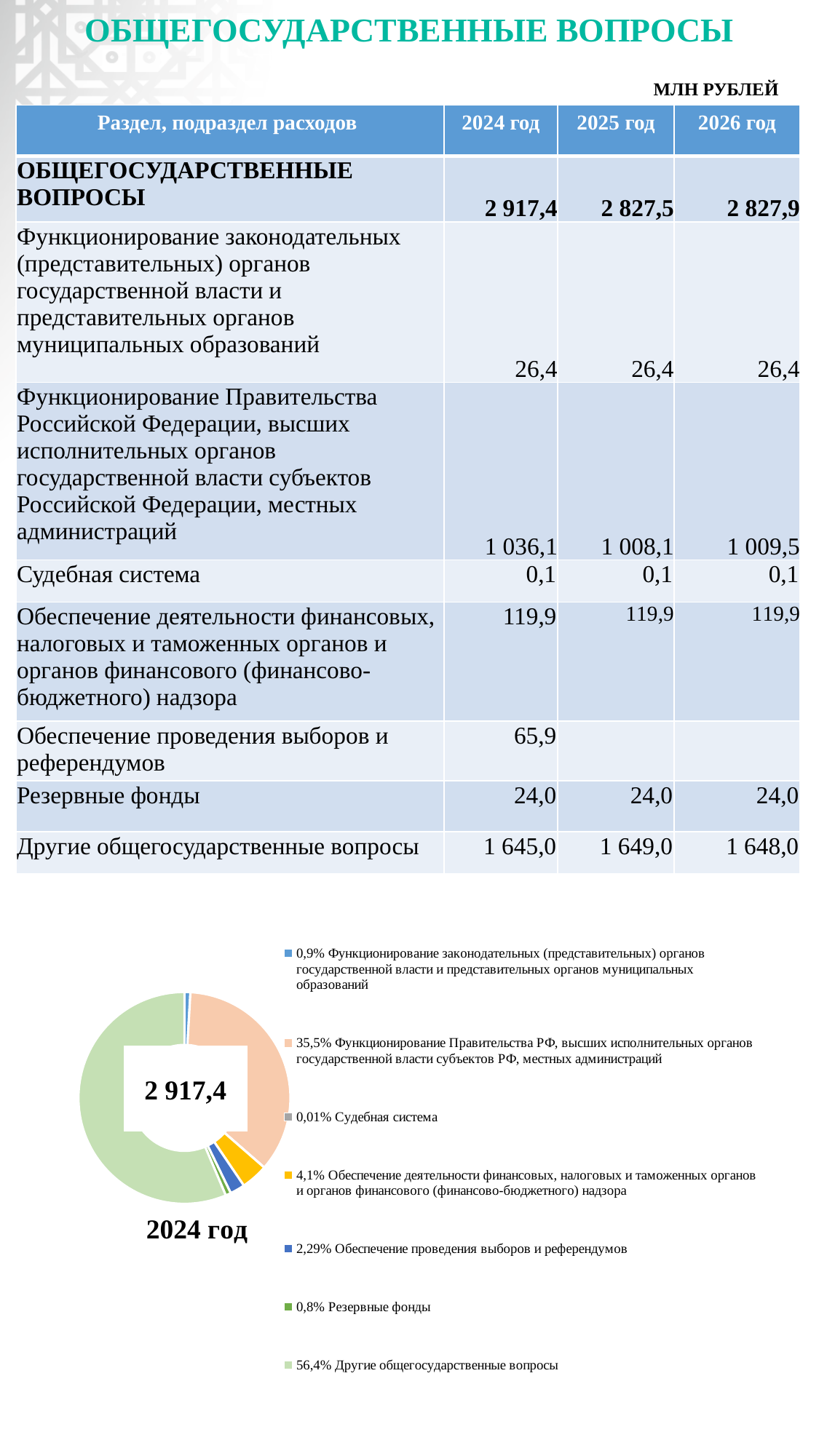
In the 2024 doughnut chart, which share is larger: "Обеспечение деятельности финансовых, налоговых и таможенных органов..." or "Обеспечение проведения выборов и референдумов"? Обеспечение деятельности финансовых, налоговых и таможенных органов и органов финансового (финансово-бюджетного) надзора What share of the 2024 doughnut chart is labelled "Судебная система"? 0,01% What share of the 2024 doughnut chart is labelled "Другие общегосударственные вопросы"? 56,4% What share of the 2024 doughnut chart is labelled "Резервные фонды"? 0,8% What total value is printed in the centre of the 2024 doughnut chart? 2 917,4 What kind of chart is shown at the bottom of the slide? Doughnut (pie) chart Which year is the doughnut chart labelled with? 2024 год Which category has the largest share in the 2024 doughnut chart? Другие общегосударственные вопросы Which category has the smallest share in the 2024 doughnut chart? Судебная система How many categories does the legend of the 2024 doughnut chart list? 7